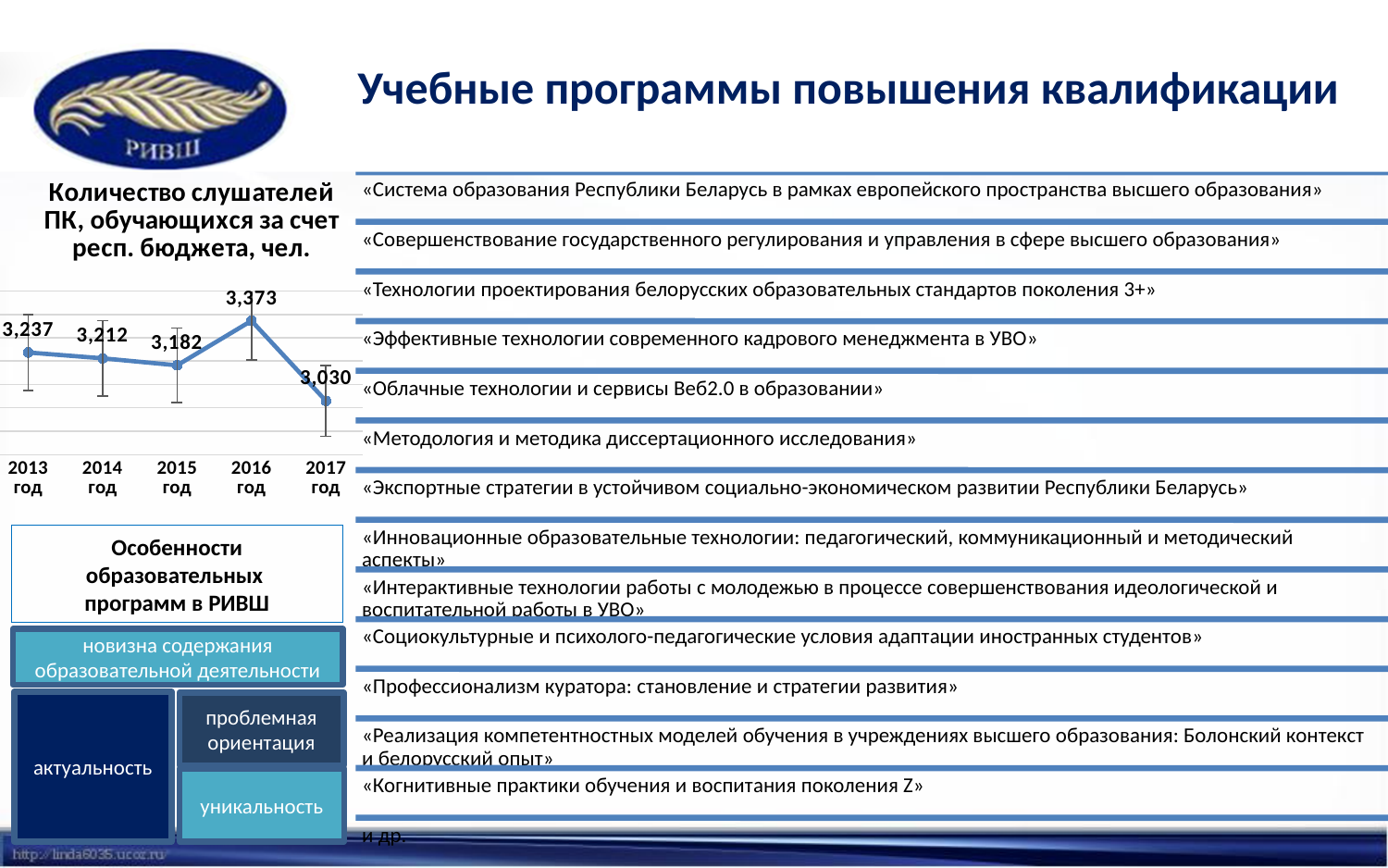
Which year has the highest value in the chart? 2016 год What is the value for 2017 год in the chart? 3,030 Which year has the lowest value in the chart? 2017 год How many years are plotted in the chart? 5 What kind of chart is shown on the slide? line chart What is the difference between the values for 2013 год and 2014 год? 25 What is the difference between the values for 2016 год and 2017 год? 343 What is the title of the chart? Количество слушателей ПК, обучающихся за счет респ. бюджета, чел. Does the value rise or fall from 2016 год to 2017 год? fall What is the value for 2015 год in the chart? 3,182 What is the value for 2013 год in the chart? 3,237 Which is larger, the value for 2014 год or the value for 2015 год? 2014 год